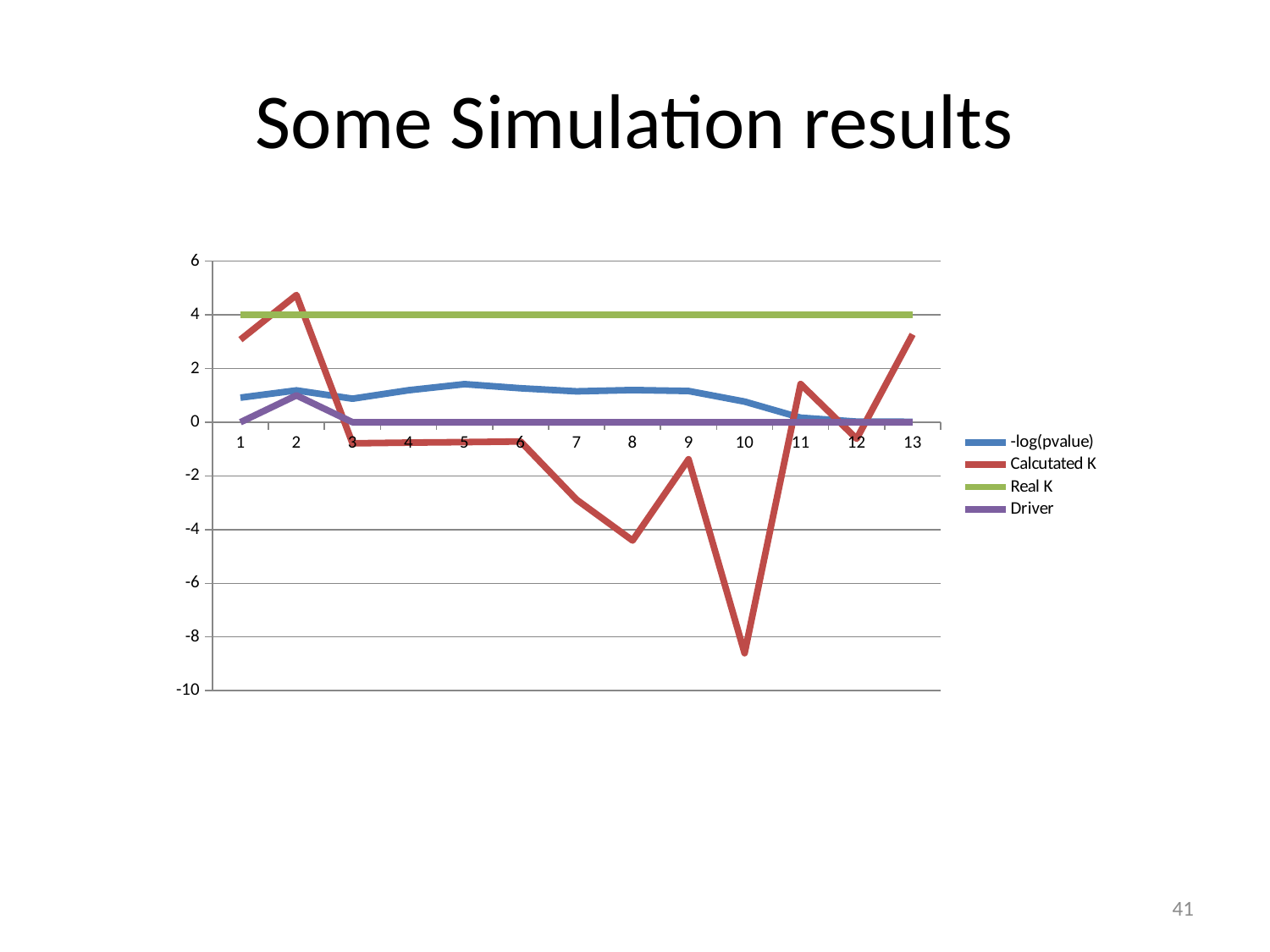
At which x-axis point does the Calcutated K series reach its highest value? 2 How many points are plotted along the x axis for each series? 13 Which colour is used for the Real K series? green What is the value of the Real K series across the chart? 4 Is the value of Calcutated K at point 2 greater or less than 4? greater At point 10, which series has the larger value, -log(pvalue) or Calcutated K? -log(pvalue) How many series does the legend list? 4 Is the value of -log(pvalue) at point 5 greater or less than 2? less What kind of chart is shown on the slide? line chart At which x-axis point does the Calcutated K series reach its lowest value? 10 What is the value of the Driver series at point 5? 0 Is the value of Calcutated K at point 10 greater or less than -8? less